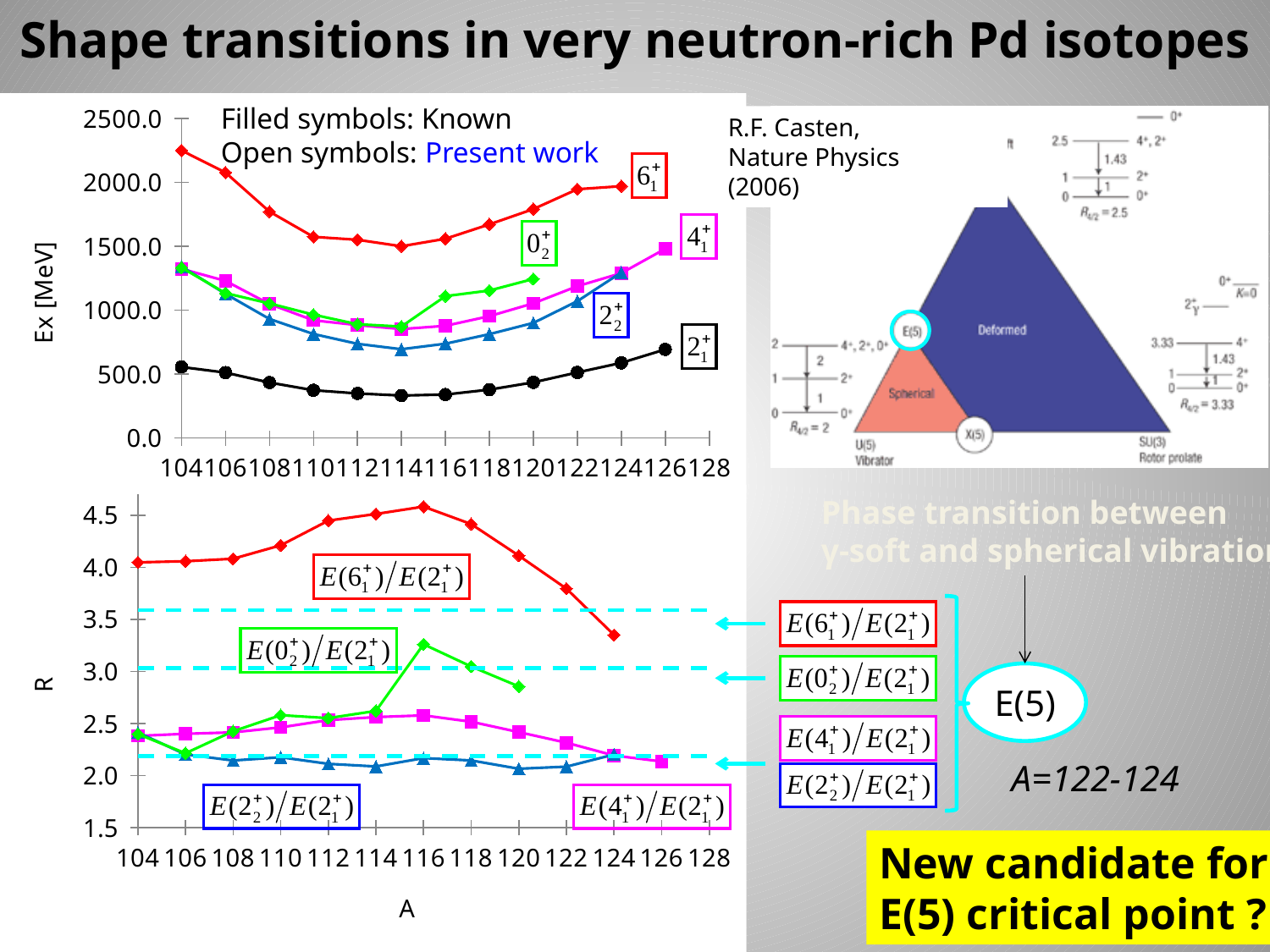
In the bottom chart, does the E(6_1^+)/E(2_1^+) series rise or fall as A goes from 116 to 124? fall What kind of chart is the top chart (Ex [MeV] versus A)? line chart In the top chart, how many labelled series are plotted? 5 What is the y-axis label of the top chart? Ex [MeV] In the bottom chart, at A=116, which is larger: E(0_2^+)/E(2_1^+) or E(4_1^+)/E(2_1^+)? E(0_2^+)/E(2_1^+) In the bottom chart, is the value of E(0_2^+)/E(2_1^+) at A=116 greater or less than 3.0? greater In the bottom chart (R versus A), is the value of E(6_1^+)/E(2_1^+) at A=124 greater or less than 3.5? less In the top chart, does the 2_1^+ series rise or fall as A goes from 104 to 114? fall In the top chart, is the value of the 6_1^+ series at A=104 greater or less than 2000.0? greater In the top chart, which labelled series has the highest excitation energies across all A? 6_1^+ In the top chart, which labelled series has the lowest excitation energies across all A? 2_1^+